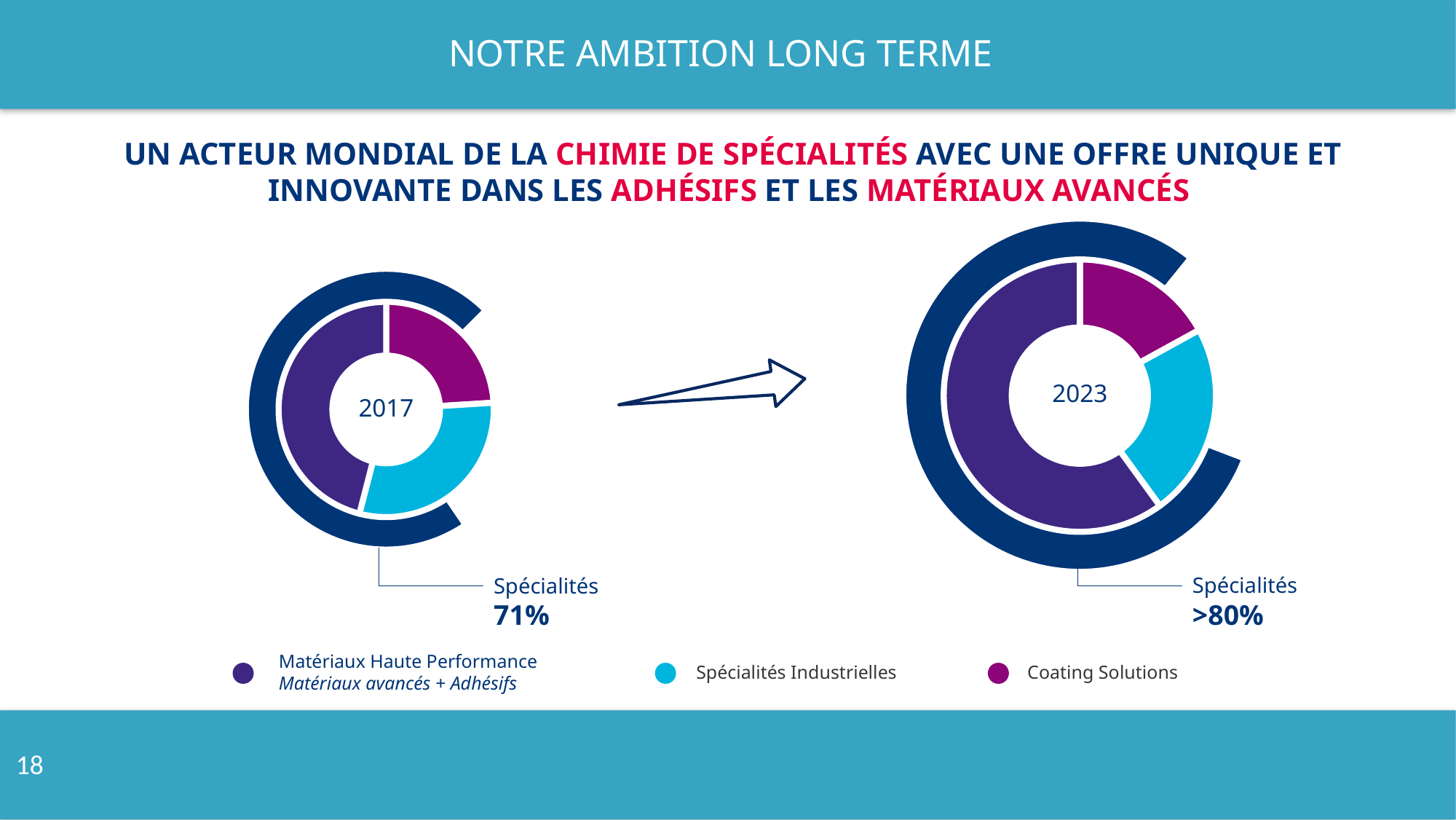
In the 2017 chart, what share is labelled for Spécialités? 71% In the 2017 chart, which category has the largest segment? Matériaux Haute Performance In the 2017 chart, which segment is larger: Matériaux Haute Performance or Spécialités Industrielles? Matériaux Haute Performance Which colour represents Coating Solutions in the legend? Magenta (purple-pink) What kind of chart is used to show the 2017 and 2023 breakdowns? Donut (pie) chart What year is shown in the centre of the right-hand donut chart? 2023 In the 2023 chart, which category has the largest segment? Matériaux Haute Performance In the 2023 chart, which category has the smallest segment? Coating Solutions How many segments does the 2017 donut chart have? 3 In the 2023 chart, what share is labelled for Spécialités? >80% How many categories does the legend list? 3 In the 2023 chart, which segment is larger: Spécialités Industrielles or Coating Solutions? Spécialités Industrielles